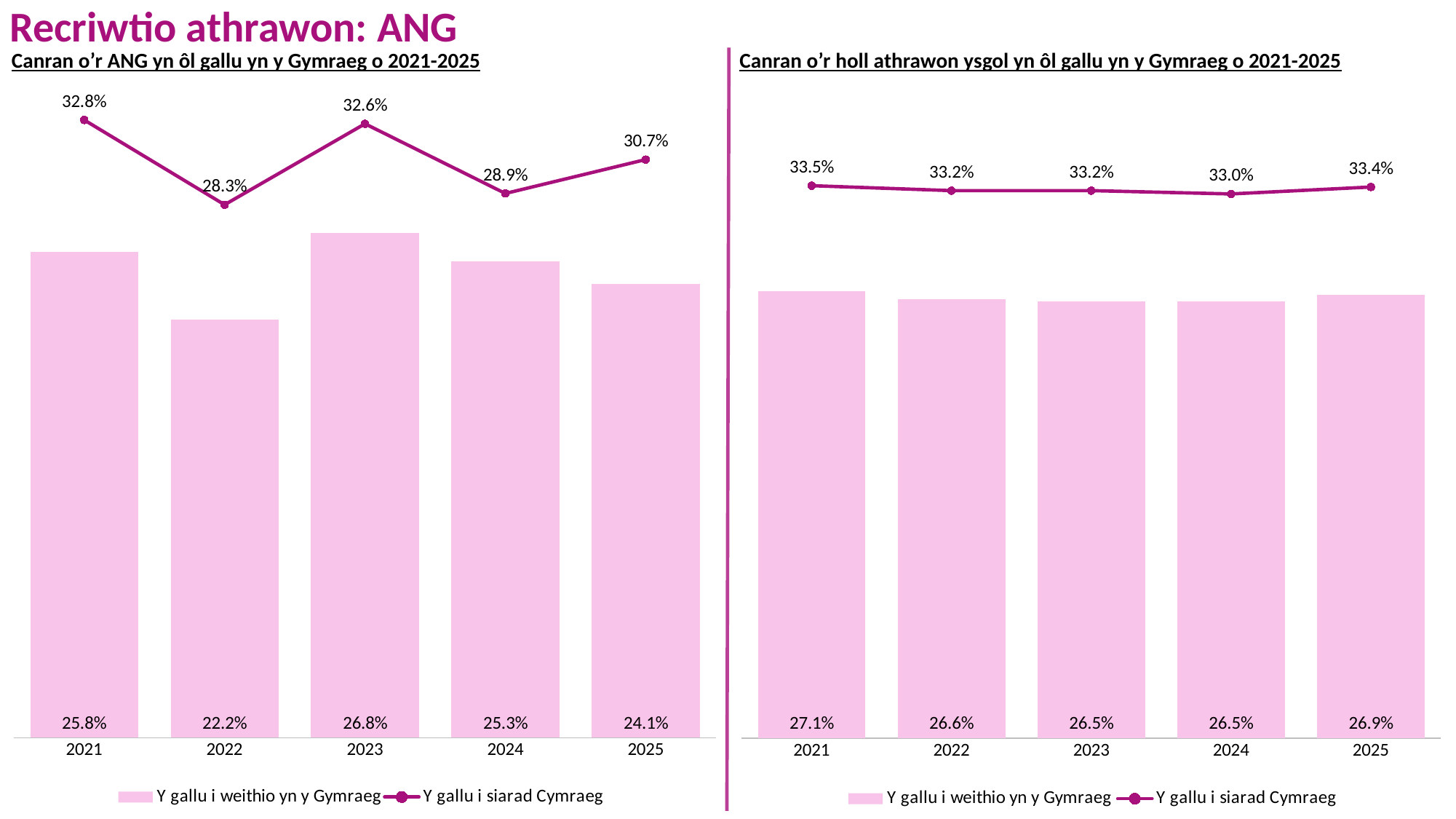
How many years are shown on the x axis of the left chart (Canran o'r ANG yn ôl gallu yn y Gymraeg o 2021-2025)? 5 In the left chart (Canran o'r ANG yn ôl gallu yn y Gymraeg o 2021-2025), what is the value of 'Y gallu i siarad Cymraeg' for 2022? 28.3% In the right chart (Canran o'r holl athrawon ysgol yn ôl gallu yn y Gymraeg o 2021-2025), what is the difference between the 'Y gallu i weithio yn y Gymraeg' values for 2021 and 2022? 0.5% In the left chart (Canran o'r ANG yn ôl gallu yn y Gymraeg o 2021-2025), what is the value of 'Y gallu i weithio yn y Gymraeg' for 2023? 26.8% In the left chart (Canran o'r ANG yn ôl gallu yn y Gymraeg o 2021-2025), which year has the lowest value for 'Y gallu i weithio yn y Gymraeg'? 2022 How many series does the legend of the right chart (Canran o'r holl athrawon ysgol yn ôl gallu yn y Gymraeg o 2021-2025) list? 2 In the right chart (Canran o'r holl athrawon ysgol yn ôl gallu yn y Gymraeg o 2021-2025), what is the value of 'Y gallu i weithio yn y Gymraeg' for 2021? 27.1% In the right chart (Canran o'r holl athrawon ysgol yn ôl gallu yn y Gymraeg o 2021-2025), which year has the highest value for 'Y gallu i siarad Cymraeg'? 2021 In the right chart (Canran o'r holl athrawon ysgol yn ôl gallu yn y Gymraeg o 2021-2025), what is the value of 'Y gallu i siarad Cymraeg' for 2024? 33.0% In the left chart (Canran o'r ANG yn ôl gallu yn y Gymraeg o 2021-2025), which year has the highest value for 'Y gallu i siarad Cymraeg'? 2021 In the left chart (Canran o'r ANG yn ôl gallu yn y Gymraeg o 2021-2025), what is the difference between the 'Y gallu i siarad Cymraeg' values for 2021 and 2025? 2.1% Which is larger: the 2025 'Y gallu i weithio yn y Gymraeg' value in the left chart or in the right chart? The right chart (26.9%)